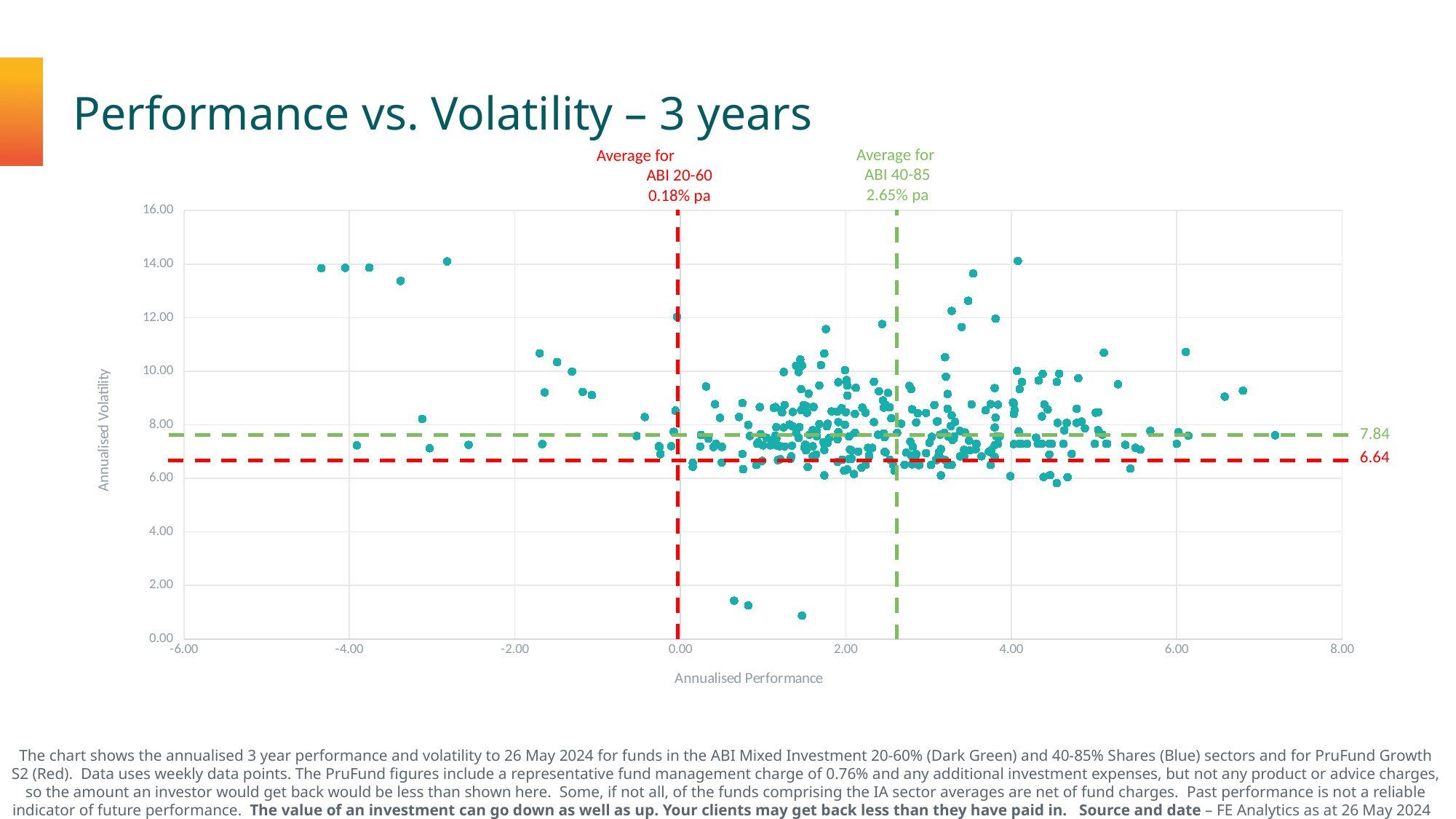
Which has the higher average annualised performance, ABI 20-60 or ABI 40-85? ABI 40-85 What is the label of the x axis? Annualised Performance What is the average annualised performance shown for ABI 40-85? 2.65% pa What is the highest value shown on the y axis? 16.00 What is the label of the y axis? Annualised Volatility What is the difference between the values of the green horizontal dashed line (7.84) and the red horizontal dashed line (6.64)? 1.20 What value is labelled on the red horizontal dashed line? 6.64 What is the difference between the average performance for ABI 40-85 (2.65% pa) and ABI 20-60 (0.18% pa)? 2.47% pa What kind of chart is shown on the slide? scatter chart Which horizontal dashed line sits at a higher volatility value, the green one or the red one? the green one What is the average annualised performance shown for ABI 20-60? 0.18% pa What value is labelled on the green horizontal dashed line? 7.84